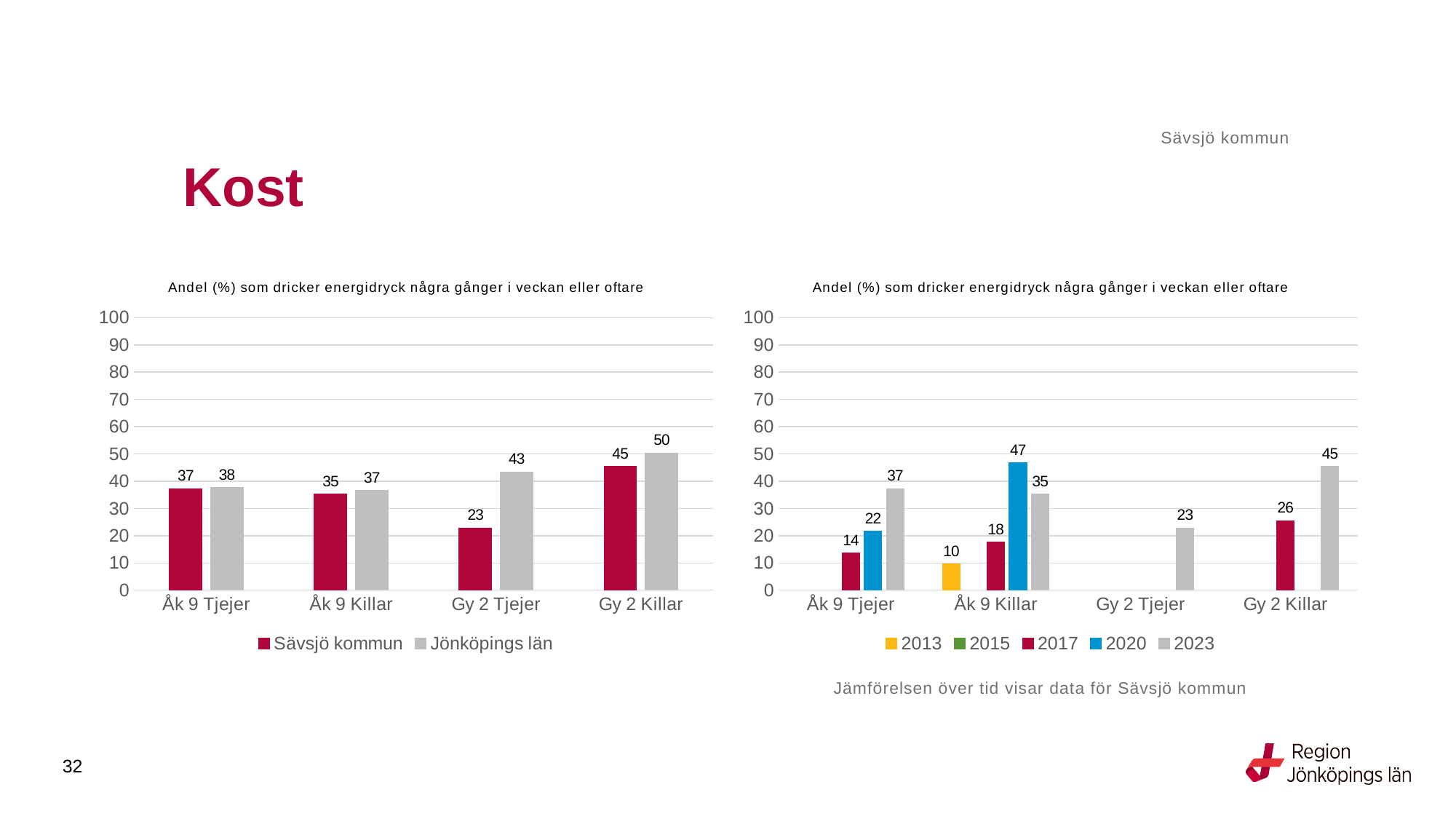
In the left chart, which category has the highest value for Jönköpings län? Gy 2 Killar In the left chart, what is the difference between Jönköpings län and Sävsjö kommun for Gy 2 Tjejer? 20 In the right chart, what is the value for 2017 for Gy 2 Killar? 26 In the right chart, what is the value for 2020 for Åk 9 Killar? 47 In the left chart, which category has the lowest value for Sävsjö kommun? Gy 2 Tjejer In the left chart, what is the value for Jönköpings län for Gy 2 Tjejer? 43 In the left chart, how many series does the legend list? 2 In the right chart, what is the difference between the 2023 and 2017 values for Åk 9 Tjejer? 23 What type of chart is the left chart? Bar chart In the left chart, what is the value for Sävsjö kommun for Gy 2 Killar? 45 In the right chart, how many series does the legend list? 5 In the right chart, which is larger for Åk 9 Tjejer: the 2020 value or the 2023 value? 2023